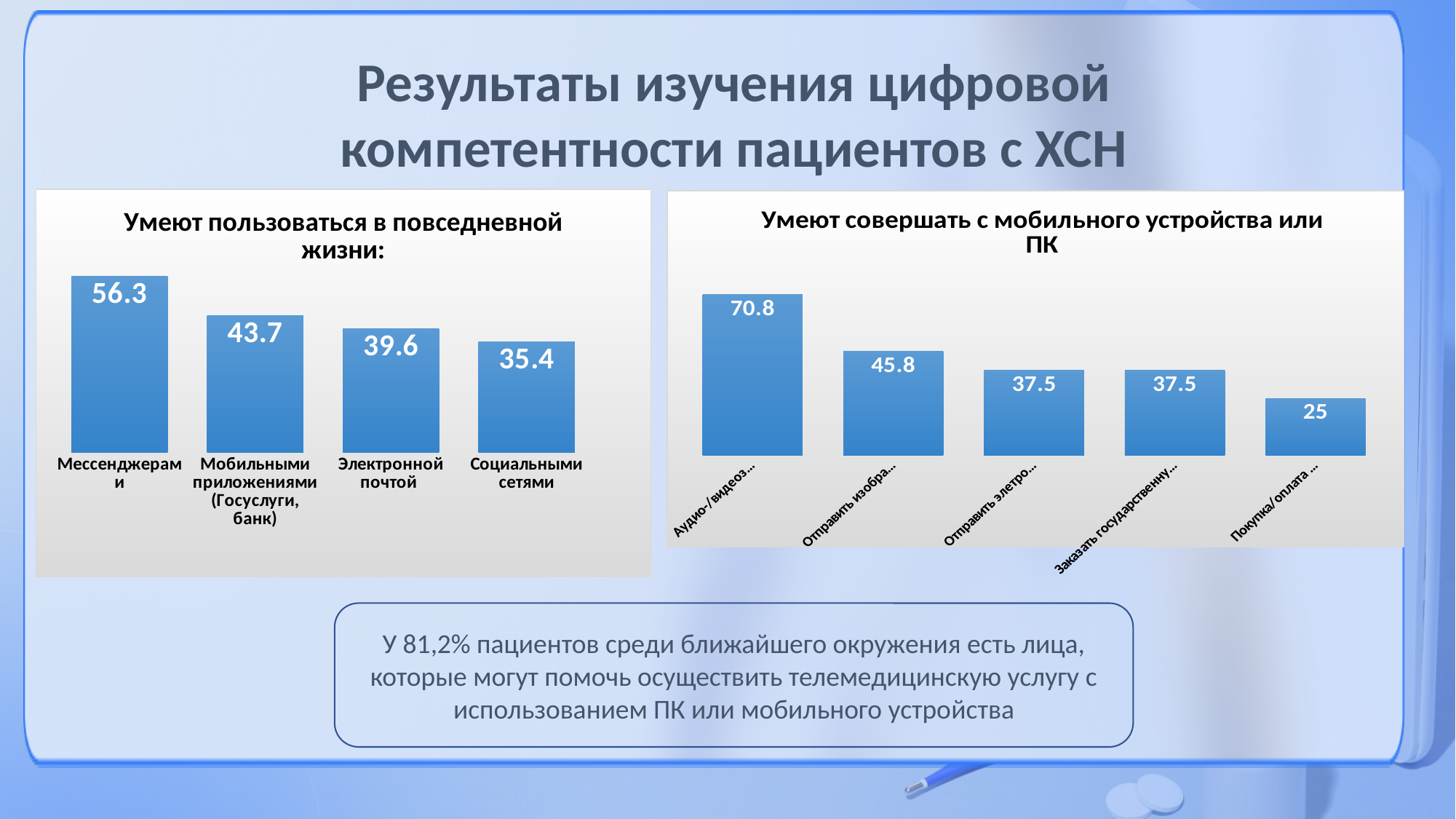
In the left chart 'Умеют пользоваться в повседневной жизни', what is the value for Мессенджерами? 56.3 In the right chart 'Умеют совершать с мобильного устройства или ПК', which bar has the highest value? Аудио-/видеоз... (the first bar) What type of chart is the left chart 'Умеют пользоваться в повседневной жизни'? bar chart In the left chart 'Умеют пользоваться в повседневной жизни', what is the difference between Мессенджерами and Мобильными приложениями (Госуслуги, банк)? 12.6 In the right chart 'Умеют совершать с мобильного устройства или ПК', what is the value of the first (leftmost) bar, Аудио-/видеоз...? 70.8 In the left chart 'Умеют пользоваться в повседневной жизни', what is the value for Электронной почтой? 39.6 In the left chart 'Умеют пользоваться в повседневной жизни', do the values rise or fall from left to right? fall In the left chart 'Умеют пользоваться в повседневной жизни', how many categories are shown? 4 In the left chart 'Умеют пользоваться в повседневной жизни', which category has the lowest value? Социальными сетями In the right chart 'Умеют совершать с мобильного устройства или ПК', what is the value of the last (rightmost) bar, Покупка/оплата...? 25 In the right chart 'Умеют совершать с мобильного устройства или ПК', what is the difference between the first bar (70.8) and the second bar (45.8)? 25 In the right chart 'Умеют совершать с мобильного устройства или ПК', how many bars are shown? 5